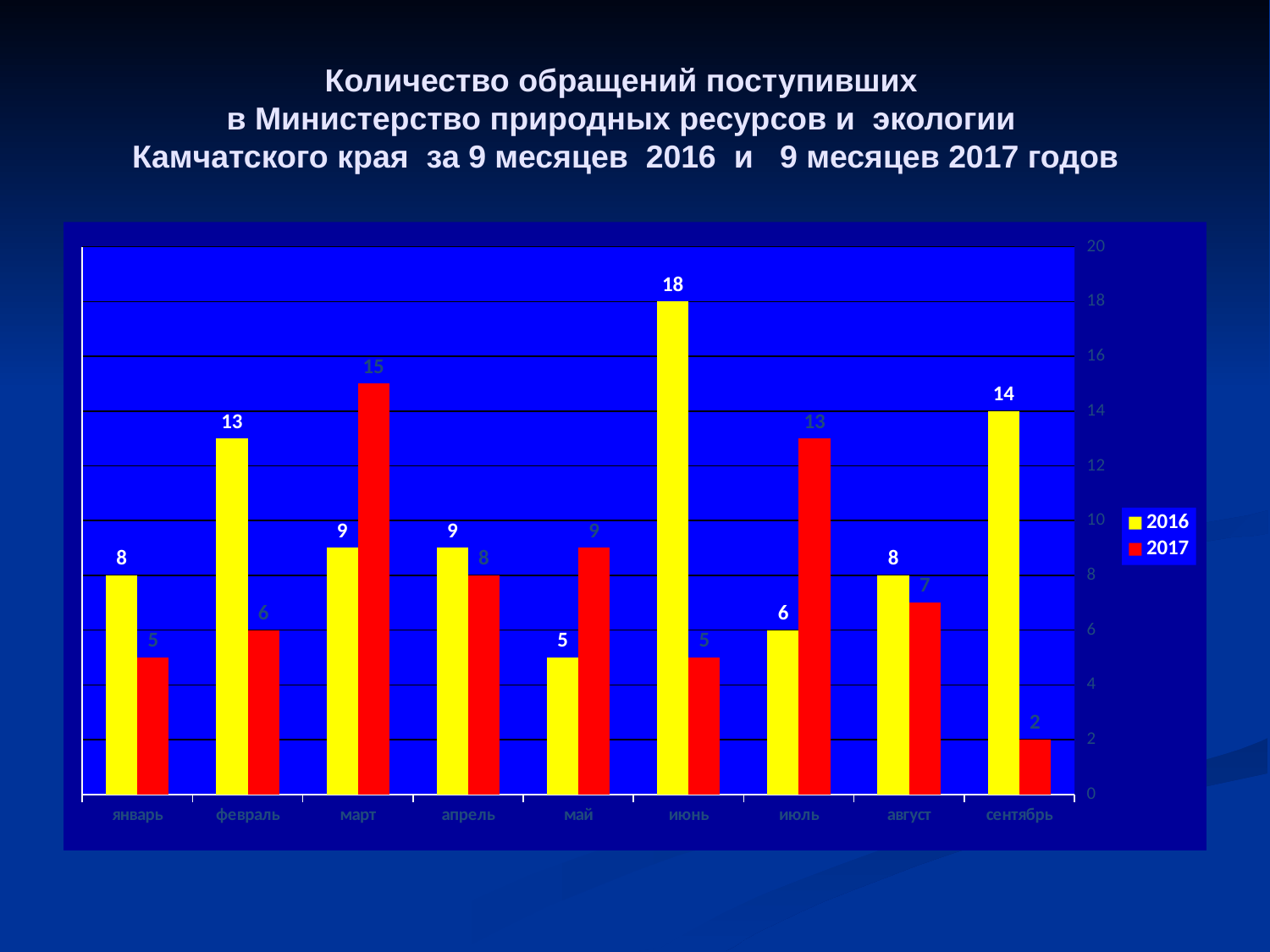
What is the difference between the 2016 and 2017 values in сентябрь? 12 Which month has the highest value for the 2016 series? июнь In июль, which series has the larger value, 2016 or 2017? 2017 Which colour represents the 2017 series in the legend? red What is the value for 2017 in сентябрь? 2 What type of chart is shown on the slide? bar chart How many series does the legend list? 2 Which month has the lowest value for the 2017 series? сентябрь What is the difference between the 2017 value in март and the 2016 value in март? 6 What is the value for 2016 in июнь? 18 What is the value for 2017 in март? 15 How many months are shown on the x axis? 9